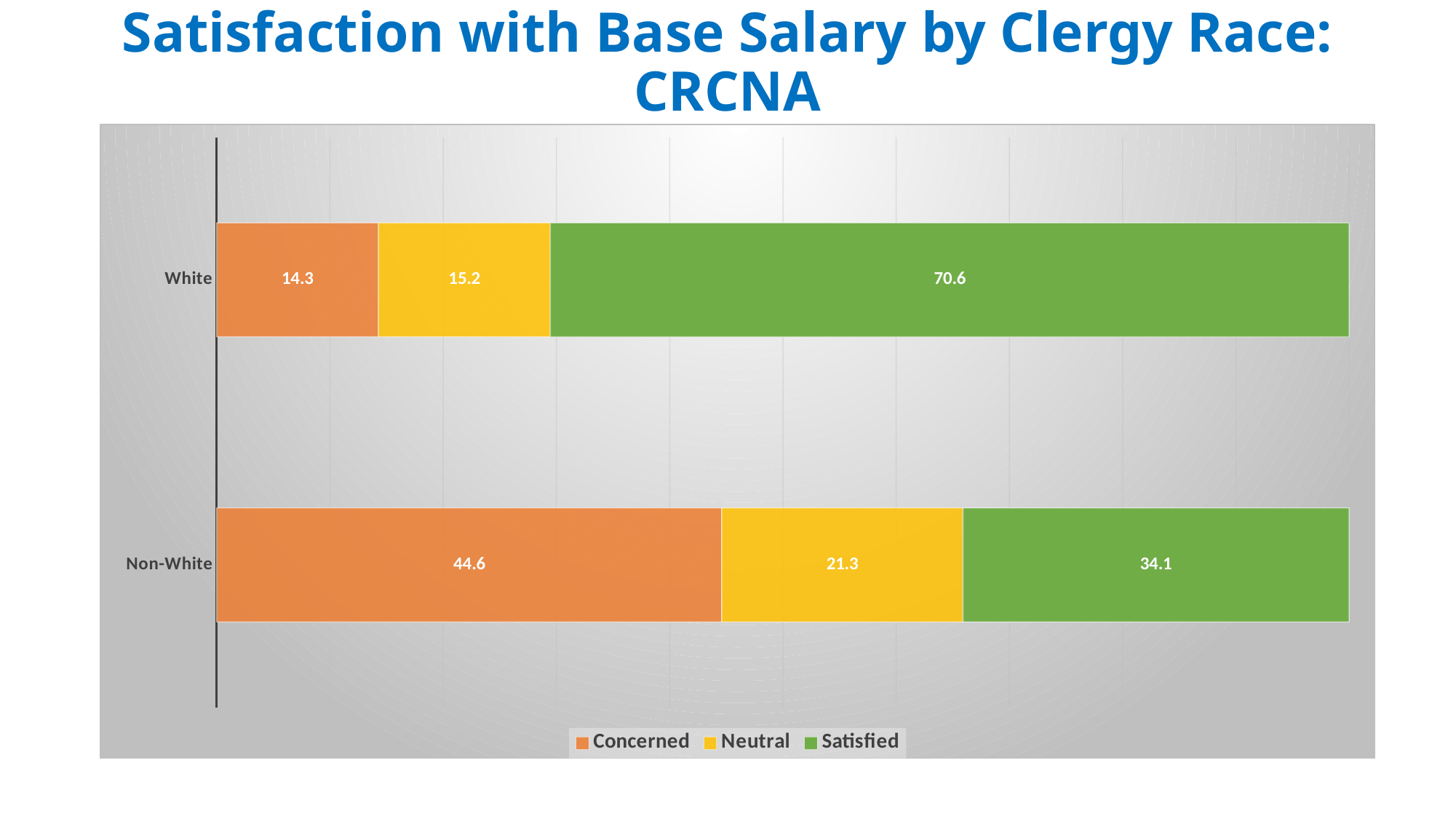
How many categories are shown on the chart? 2 Which category has the higher Concerned value, White or Non-White? Non-White What is the Neutral value for Non-White clergy? 21.3 How many series does the legend list? 3 What is the Concerned value for Non-White clergy? 44.6 What is the Neutral value for White clergy? 15.2 What is the difference between the Concerned values for Non-White and White clergy? 30.3 What is the difference between the Satisfied values for White and Non-White clergy? 36.5 Which category has the highest Satisfied value? White What kind of chart is shown on the slide? Stacked bar chart What is the Satisfied value for White clergy? 70.6 Which colour represents the Satisfied series in the legend? Green